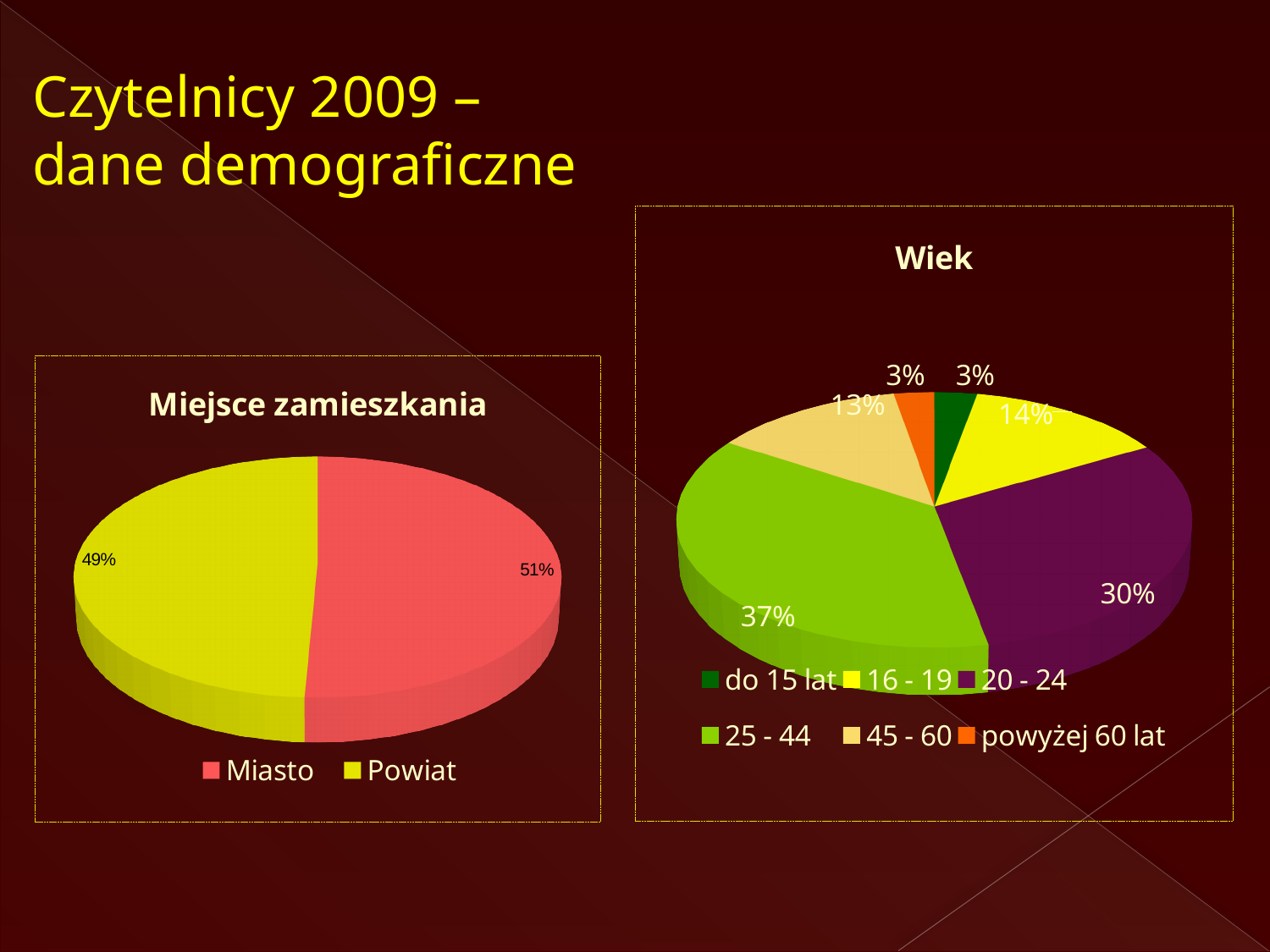
In the "Wiek" chart, which age group has the largest share? 25 - 44 In the "Miejsce zamieszkania" chart, which category has the larger share, Miasto or Powiat? Miasto In the "Wiek" chart, what share is labelled for the 16 - 19 age group? 14% In the "Wiek" chart, what share is labelled for the 25 - 44 age group? 37% In the "Miejsce zamieszkania" chart, what share of readers is labelled for Miasto? 51% In the "Wiek" chart, what is the difference in percentage points between the 25 - 44 and 20 - 24 groups? 7 percentage points In the "Miejsce zamieszkania" chart, what share of readers is labelled for Powiat? 49% What kind of chart is the "Miejsce zamieszkania" chart? Pie chart In the "Wiek" chart, what share is labelled for the 20 - 24 age group? 30% In the "Wiek" chart, how many age groups does the legend list? 6 In the "Miejsce zamieszkania" chart, what is the difference in percentage points between Miasto and Powiat? 2 percentage points In the "Wiek" chart, which colour represents the 45 - 60 age group? Beige (light tan)